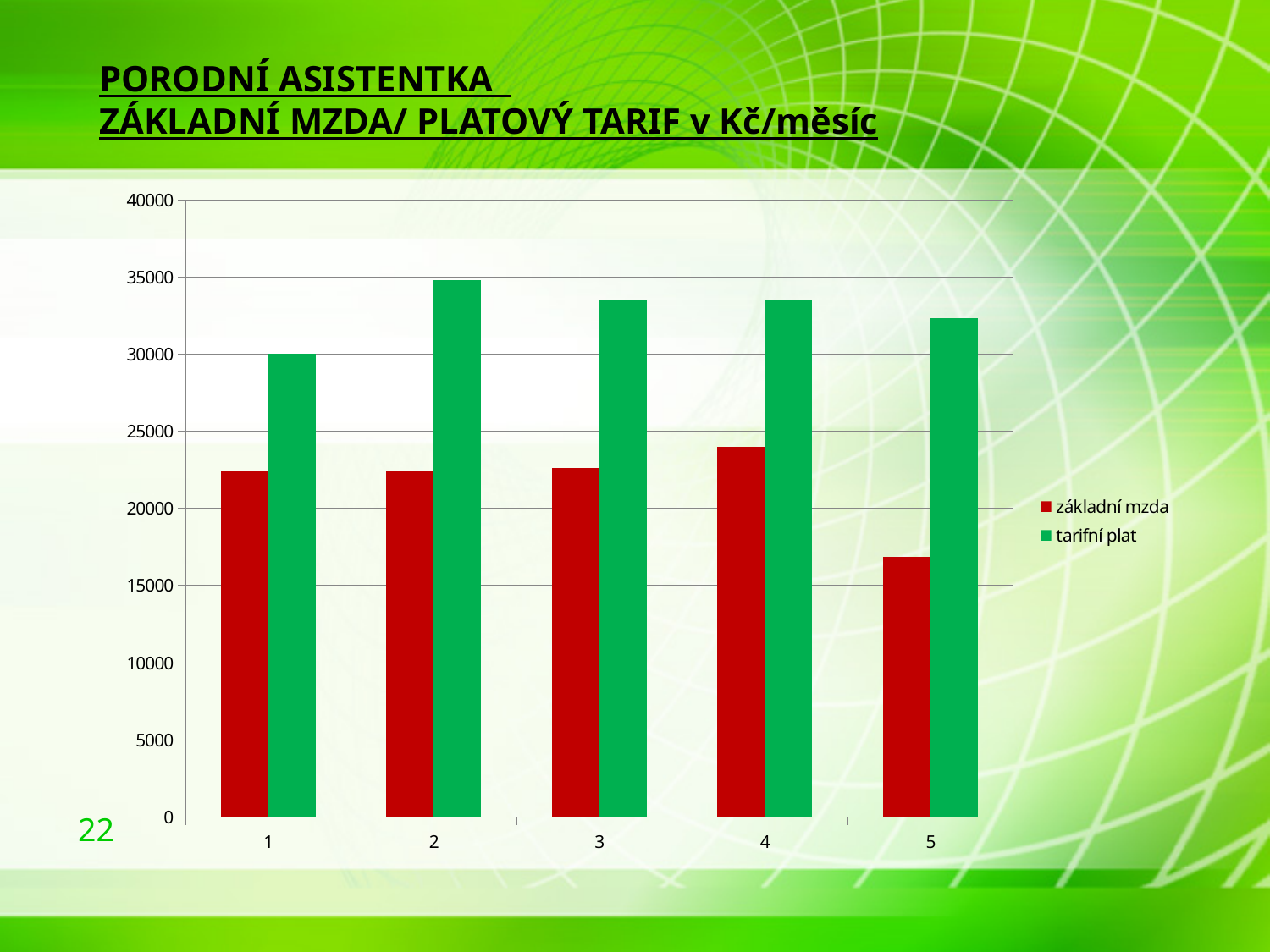
Is the základní mzda for category 4 greater or less than 25000? less Which colour represents základní mzda in the legend? red Which category has the highest základní mzda? 4 How many categories are shown on the x axis? 5 Is the tarifní plat for category 5 greater or less than 30000? greater Which category has the lowest tarifní plat? 1 For category 1, which is larger: základní mzda or tarifní plat? tarifní plat Which category has the lowest základní mzda? 5 Which category has the highest tarifní plat? 2 Is the základní mzda for category 5 greater or less than 20000? less What kind of chart is shown on the slide? bar chart How many series does the legend list? 2